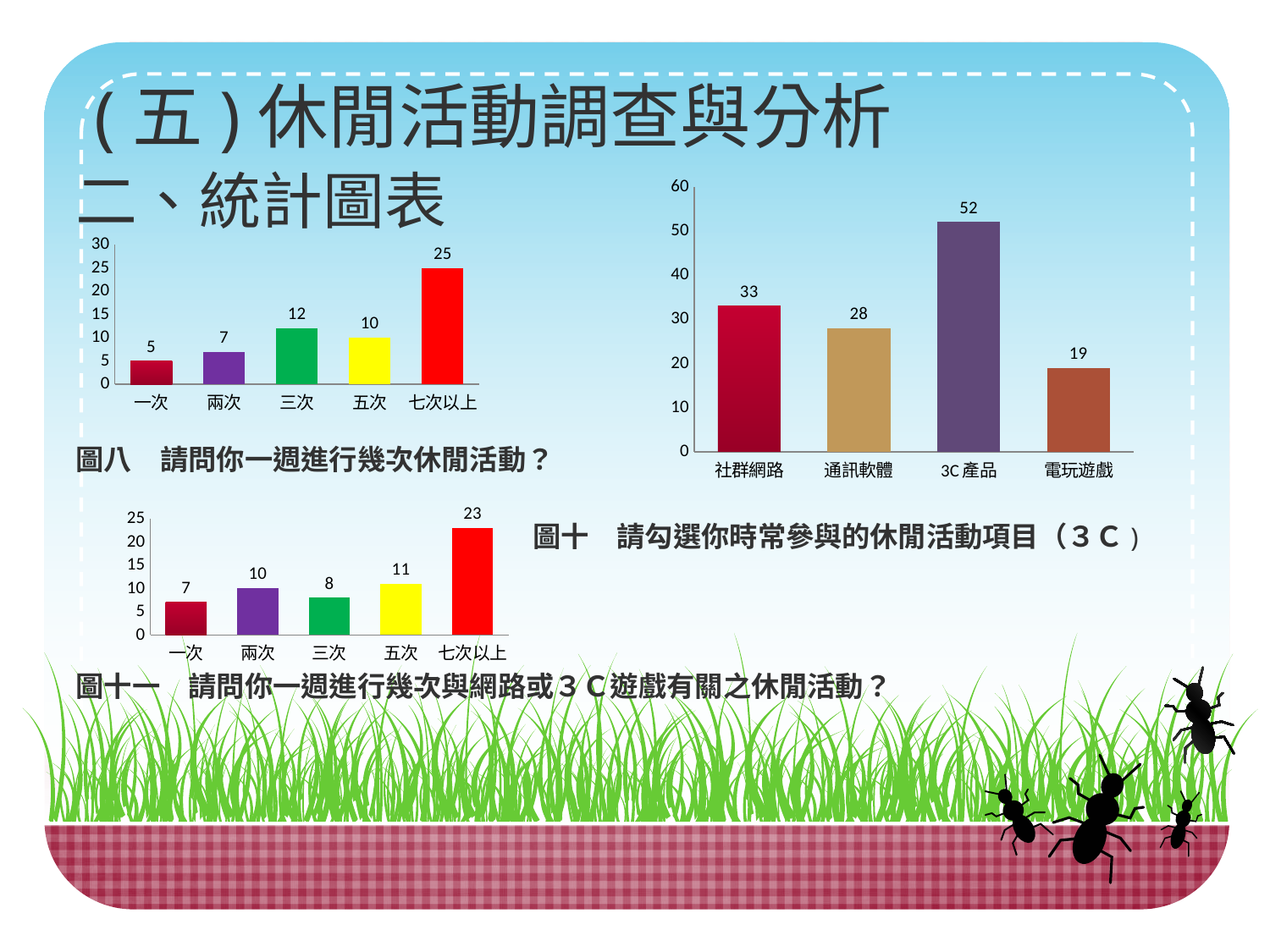
In the chart labelled 圖十 (right), what is the value for 3C 產品? 52 In the chart labelled 圖八 (top-left), what is the difference between 三次 and 五次? 2 In the chart labelled 圖十一 (bottom-left), which is larger, 兩次 or 三次? 兩次 In the chart labelled 圖十 (right), which category has the highest value? 3C 產品 In the chart labelled 圖十 (right), what is the difference between 3C 產品 and 電玩遊戲? 33 In the chart labelled 圖十一 (bottom-left), which category has the highest value? 七次以上 In the chart labelled 圖八 (top-left), which category has the lowest value? 一次 What type of chart is the chart labelled 圖十 (right)? Bar chart In the chart labelled 圖十 (right), which is larger, 社群網路 or 通訊軟體? 社群網路 In the chart labelled 圖八 (top-left), how many categories are shown? 5 In the chart labelled 圖十一 (bottom-left), what is the value for 五次? 11 In the chart labelled 圖八 (top-left), what is the value for 七次以上? 25